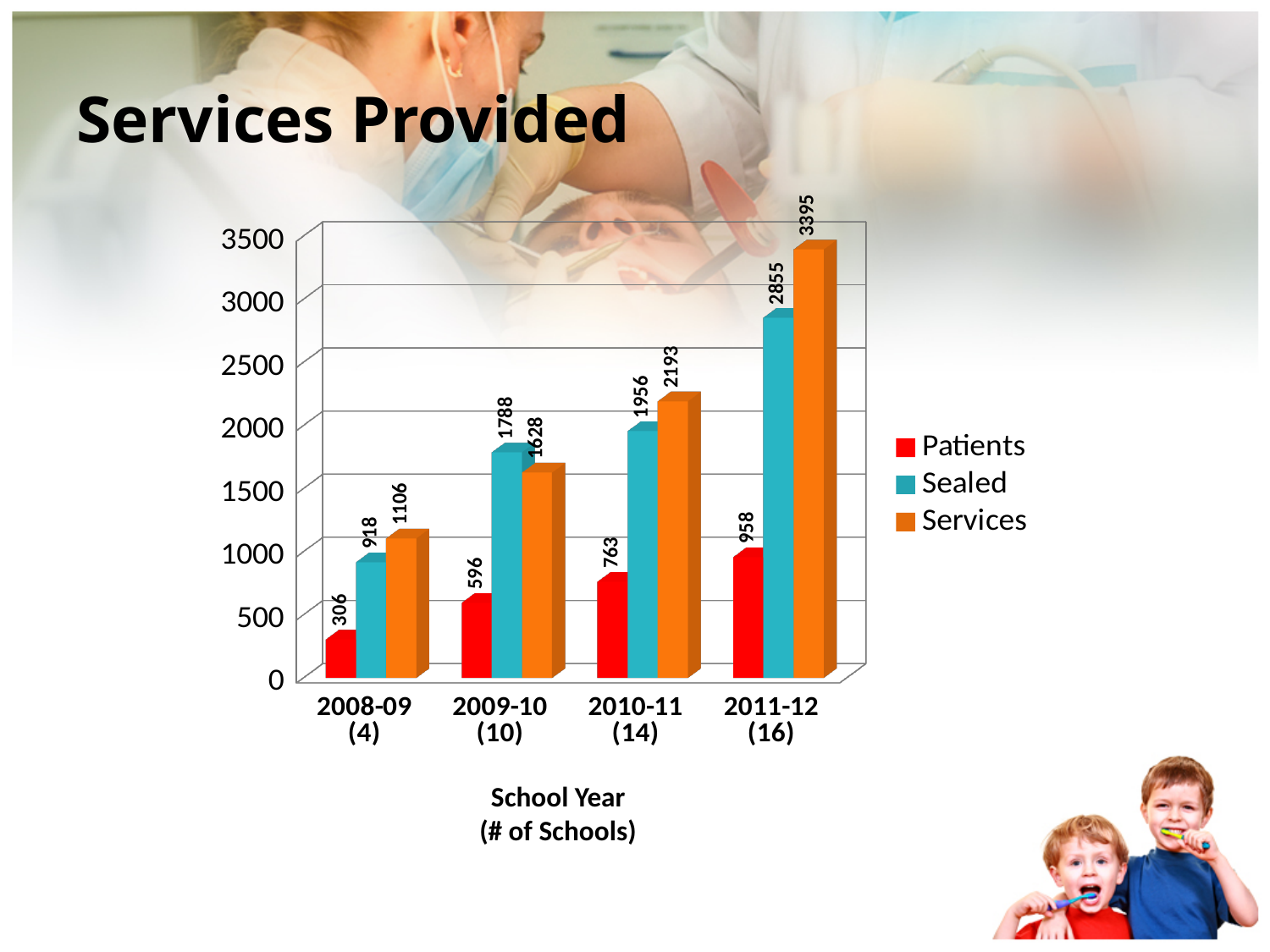
Which school year has the lowest value for Patients? 2008-09 (4) What is the difference between Services and Sealed in 2011-12 (16)? 540 Which school year has the highest value for Sealed? 2011-12 (16) How many series does the legend list? 3 What is the value for Sealed in 2009-10 (10)? 1788 What is the value for Services in 2011-12 (16)? 3395 What is the value for Services in 2010-11 (14)? 2193 What is the value for Patients in 2008-09 (4)? 306 What kind of chart is shown on the slide? Bar chart How many school years are shown on the x axis? 4 Which is larger in 2009-10 (10): Sealed or Services? Sealed Do the Patients values rise or fall from 2008-09 to 2011-12? Rise